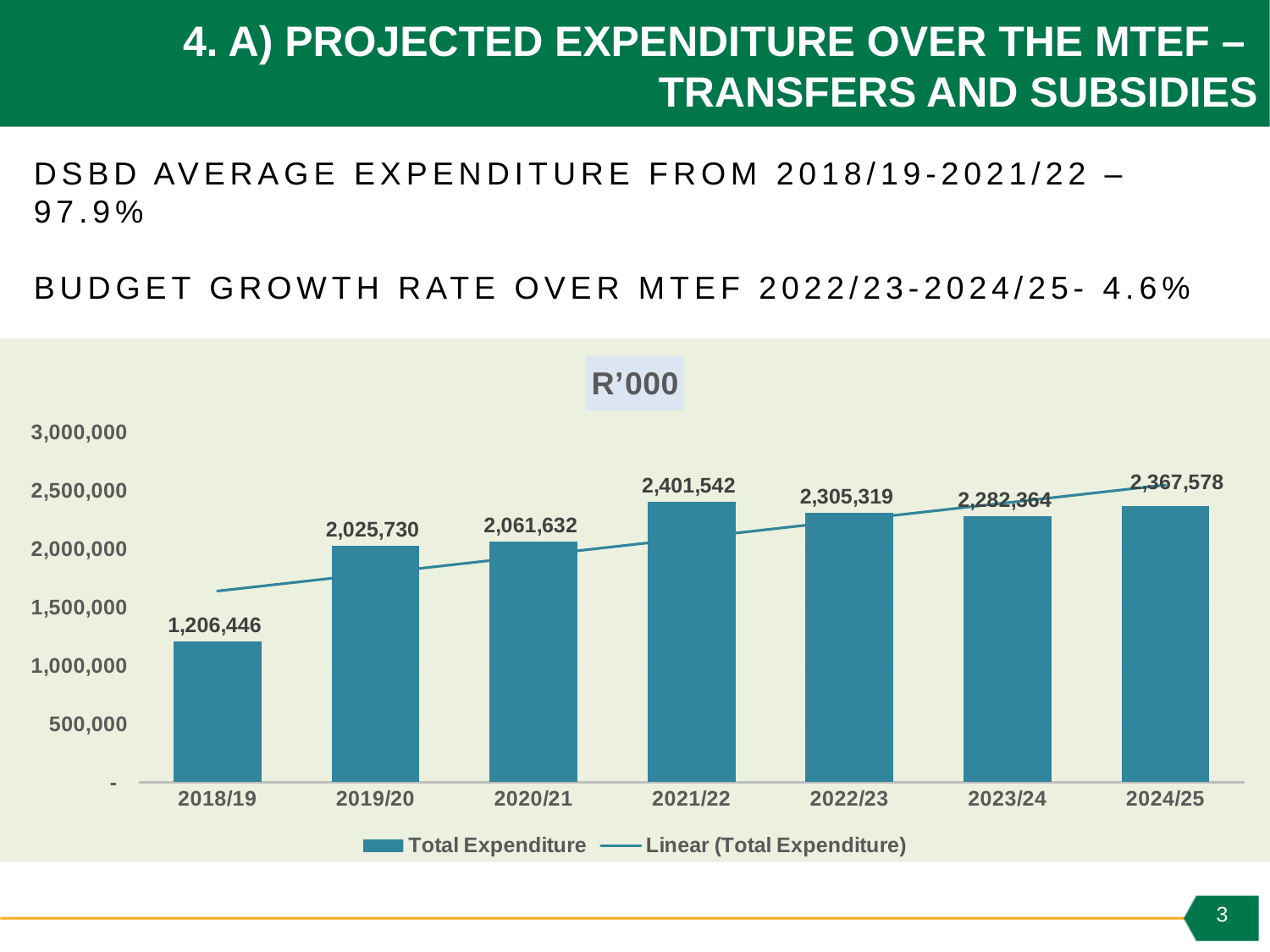
What is the Total Expenditure value for 2021/22? 2,401,542 What is the difference between the Total Expenditure for 2021/22 and 2018/19? 1,195,096 What is the title of the chart? R'000 Which year has the highest Total Expenditure? 2021/22 Is the Total Expenditure for 2019/20 greater or less than 2,500,000? less What is the Total Expenditure value for 2018/19? 1,206,446 Which is larger, the Total Expenditure for 2022/23 or for 2023/24? 2022/23 Which year has the lowest Total Expenditure? 2018/19 What kind of chart is shown on the slide? bar chart What is the difference between the Total Expenditure for 2024/25 and 2023/24? 85,214 What is the Total Expenditure value for 2024/25? 2,367,578 How many years are shown on the x axis of the chart? 7